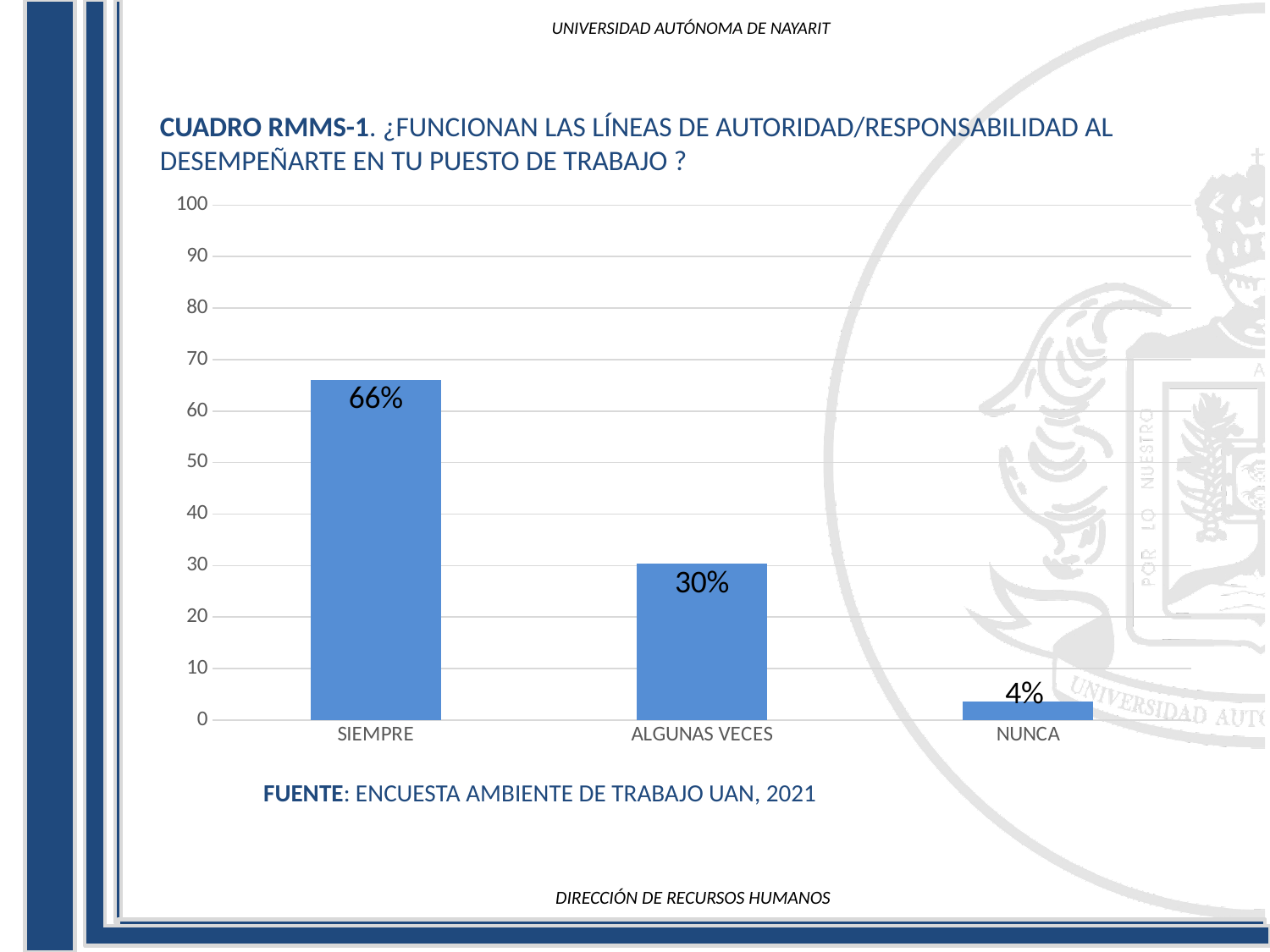
How many categories are shown on the x axis? 3 What is the difference between the values for SIEMPRE and ALGUNAS VECES? 36% Is the value for SIEMPRE greater or less than 60? greater What is the value for ALGUNAS VECES? 30% Which category has the highest value? SIEMPRE What is the value for NUNCA? 4% What source is cited below the chart? ENCUESTA AMBIENTE DE TRABAJO UAN, 2021 What is the difference between the values for ALGUNAS VECES and NUNCA? 26% Which category has the lowest value? NUNCA What kind of chart is shown on the slide? bar chart What is the value for SIEMPRE? 66% Which is larger, the value for ALGUNAS VECES or the value for NUNCA? ALGUNAS VECES